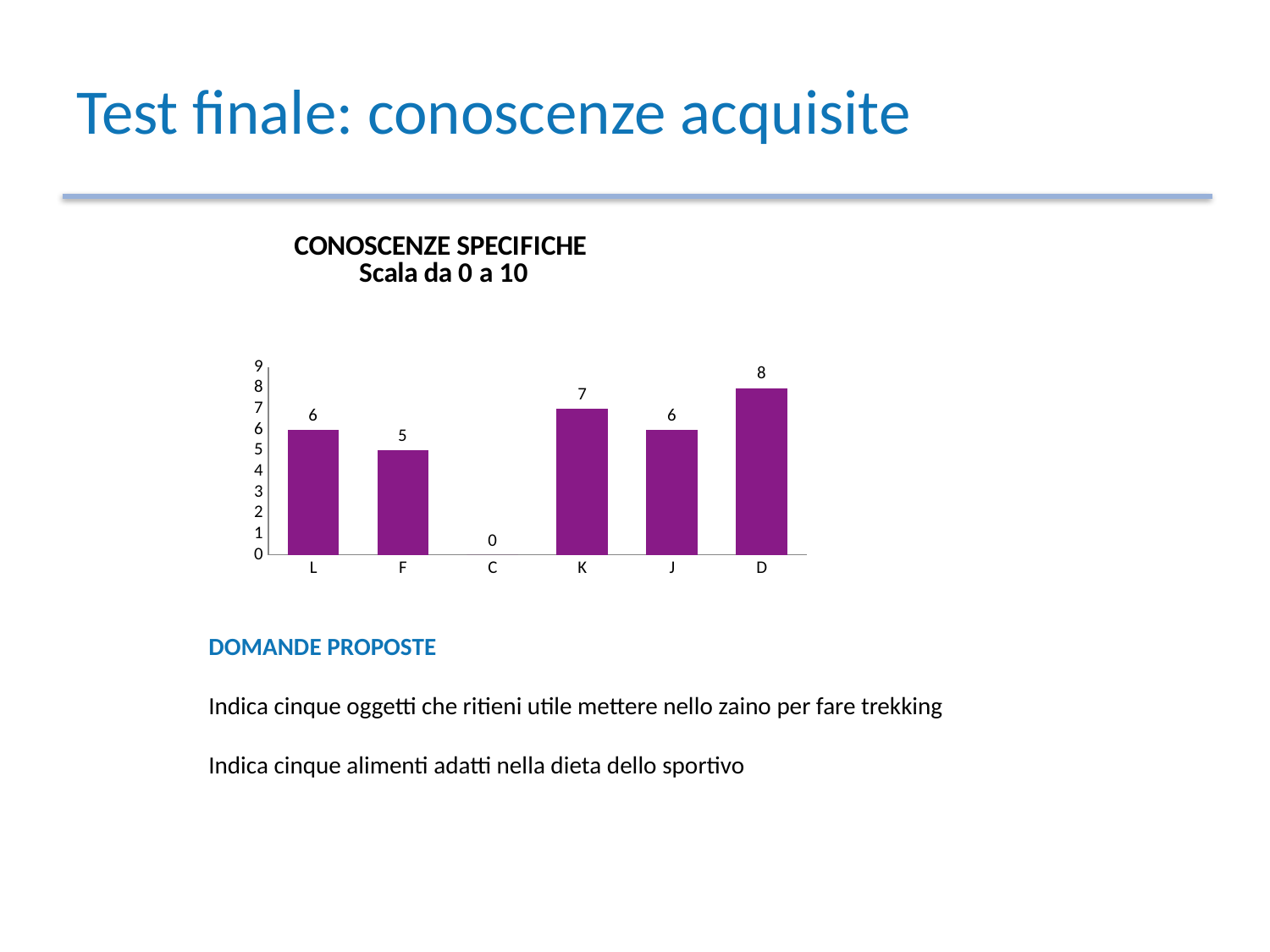
How many categories are shown on the x axis? 6 What is the difference between the values for D and F? 3 What kind of chart is shown on the slide? bar chart Which category has the lowest value? C What is the value for C? 0 What is the value for F? 5 What colour are the bars in the chart? purple Which category has the highest value? D Is the value for D greater or less than 5? greater What is the value for K? 7 What is the title of the chart? CONOSCENZE SPECIFICHE Scala da 0 a 10 Which is larger, the value for K or the value for J? K